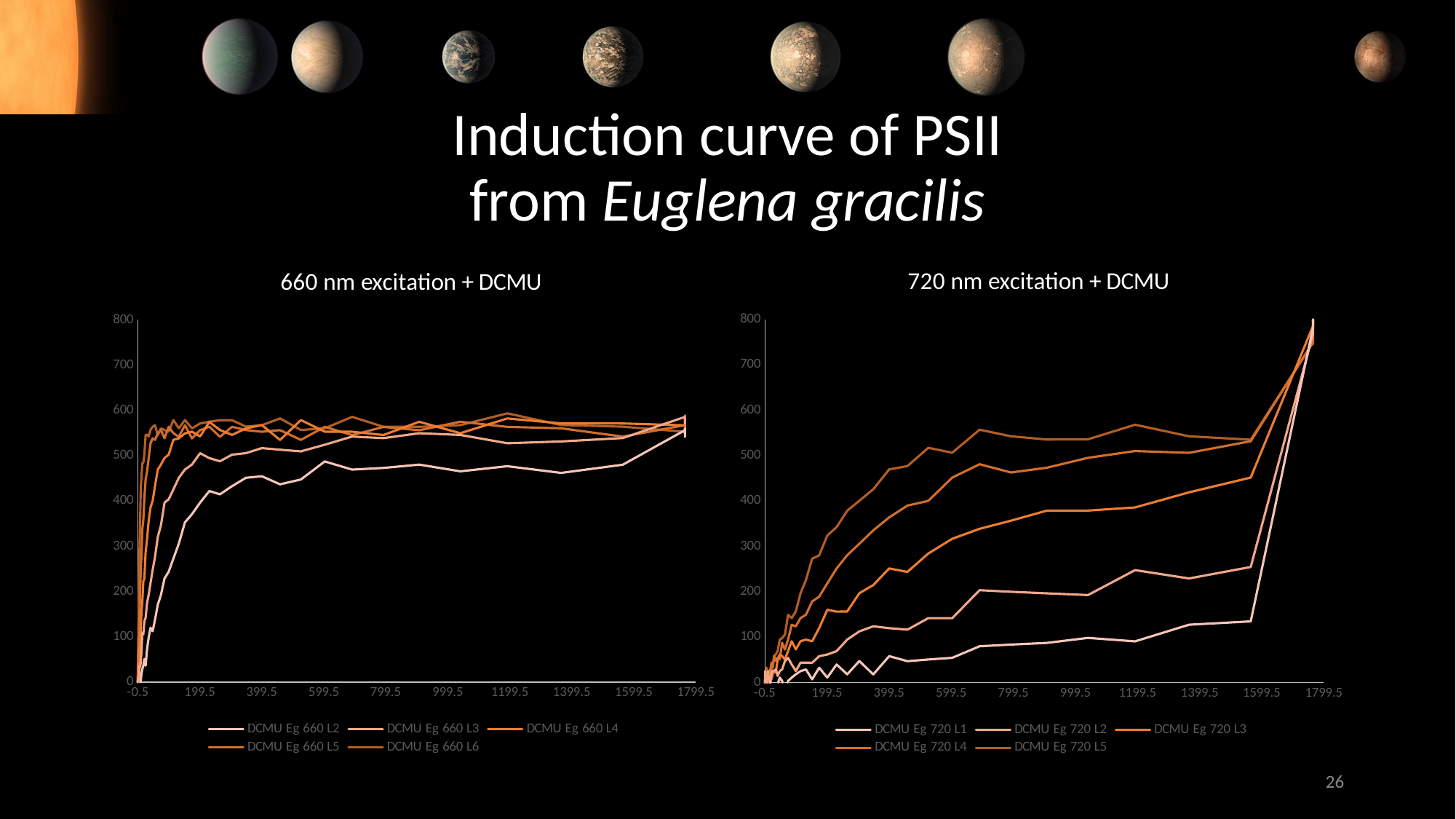
In the '720 nm excitation + DCMU' chart, is the value of the highest line at x = 1799.5 greater or less than 700? greater What is the title of the chart on the left of the slide? 660 nm excitation + DCMU In the '720 nm excitation + DCMU' chart, is the value of the highest line at x = 199.5 greater or less than 400? less How many series does the legend of the '720 nm excitation + DCMU' chart list? 5 What is the title of the chart on the right of the slide? 720 nm excitation + DCMU What kind of chart is the '660 nm excitation + DCMU' chart? line chart How many series does the legend of the '660 nm excitation + DCMU' chart list? 5 In the '660 nm excitation + DCMU' chart, is the value of the highest line at x = 999.5 greater or less than 500? greater In the '720 nm excitation + DCMU' chart, do the values generally rise or fall along the x axis? rise What kind of chart is the '720 nm excitation + DCMU' chart? line chart